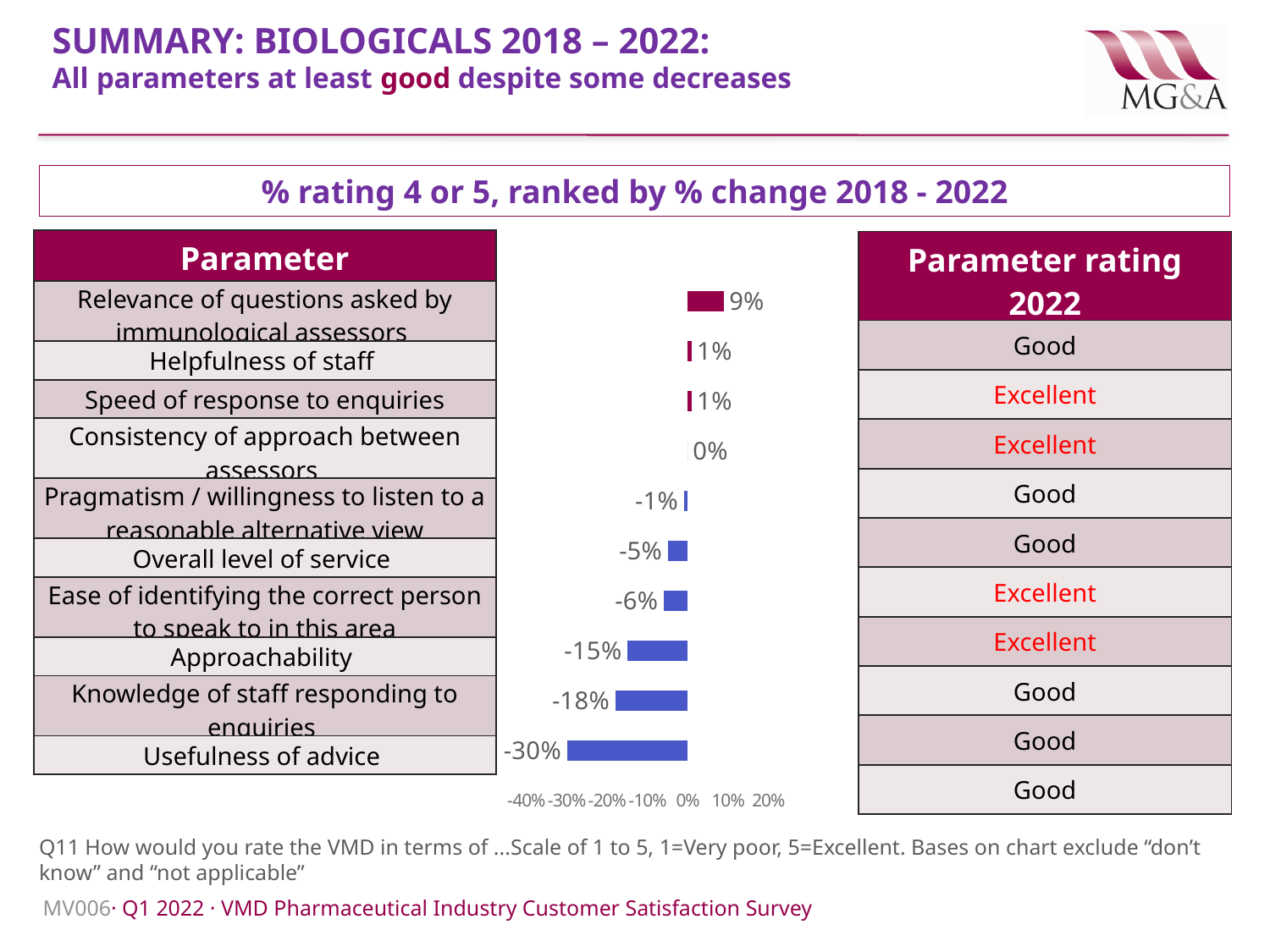
Which parameter has the lowest % change 2018 - 2022? Usefulness of advice What is the % change 2018 - 2022 for Knowledge of staff responding to enquiries? -18% What is the % change 2018 - 2022 for Consistency of approach between assessors? 0% How many parameters are plotted in the % change chart? 10 Which has a larger % change 2018 - 2022: Overall level of service or Ease of identifying the correct person to speak to in this area? Overall level of service What is the difference between the % change for Approachability and the % change for Usefulness of advice? 15% What is the title of the chart? % rating 4 or 5, ranked by % change 2018 - 2022 What is the % change 2018 - 2022 for Relevance of questions asked by immunological assessors? 9% What is the % change 2018 - 2022 for Approachability? -15% What is the % change 2018 - 2022 for Usefulness of advice? -30% What kind of chart is used to show the % change 2018 - 2022? Bar chart Which parameter has the largest positive % change 2018 - 2022? Relevance of questions asked by immunological assessors